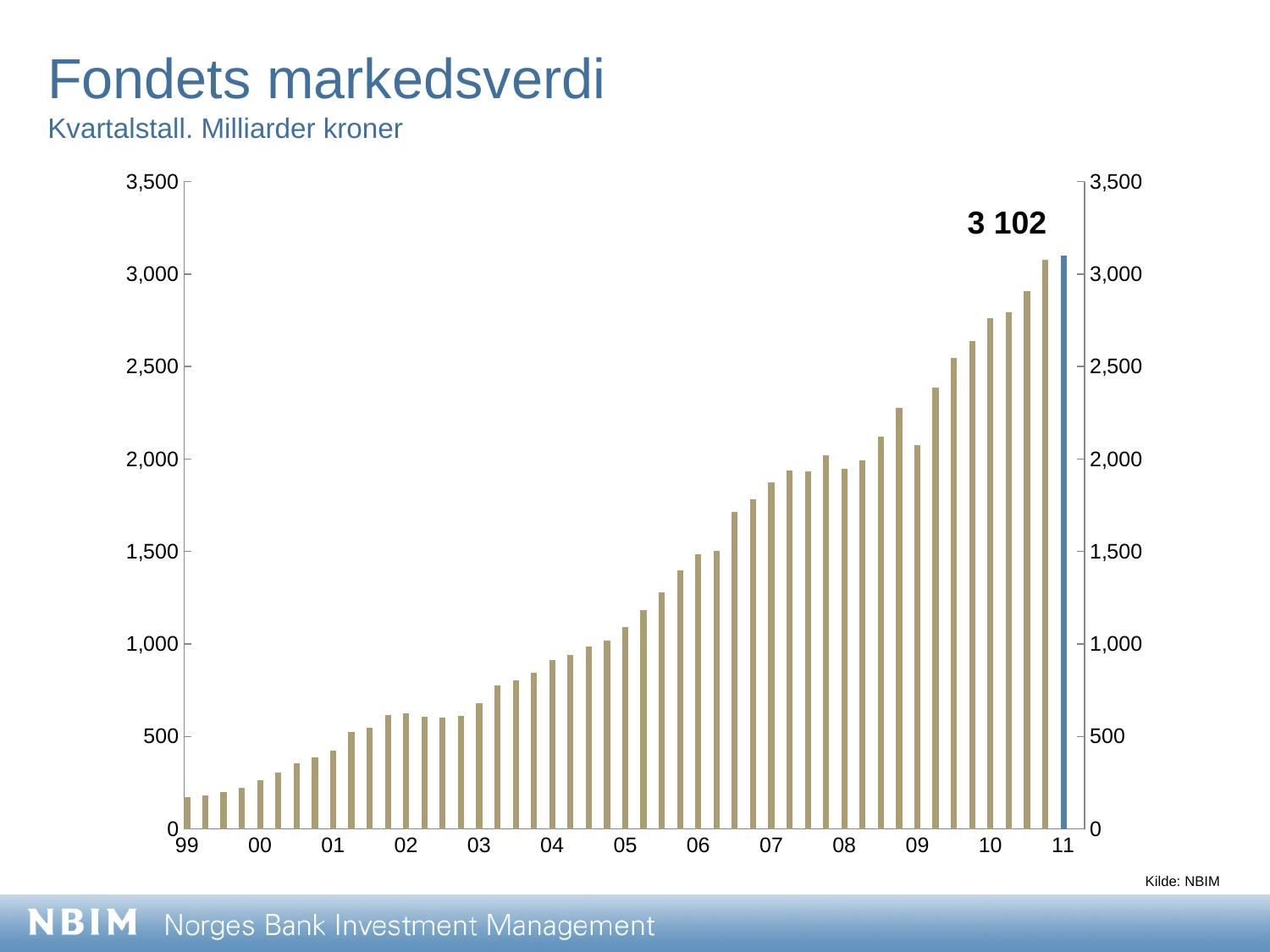
Is the value of the bar at the 06 tick greater or less than 1,000? greater Is the value of the bar at the 10 tick greater or less than 2,500? greater Which bar is the highest in the chart? the last bar, at 11 (2011) Is the value of the bar at the 02 tick greater or less than 500? greater What value is printed above the final (blue) bar at 11? 3 102 How many year labels are shown on the x axis? 13 What kind of chart is shown on the slide? bar chart Do the values generally rise or fall from 99 to 11? rise Which bar is the lowest in the chart? the first bar, at 99 (1999) Which is larger, the bar at the 10 tick or the bar at the 05 tick? the bar at 10 What is the title of the chart? Fondets markedsverdi